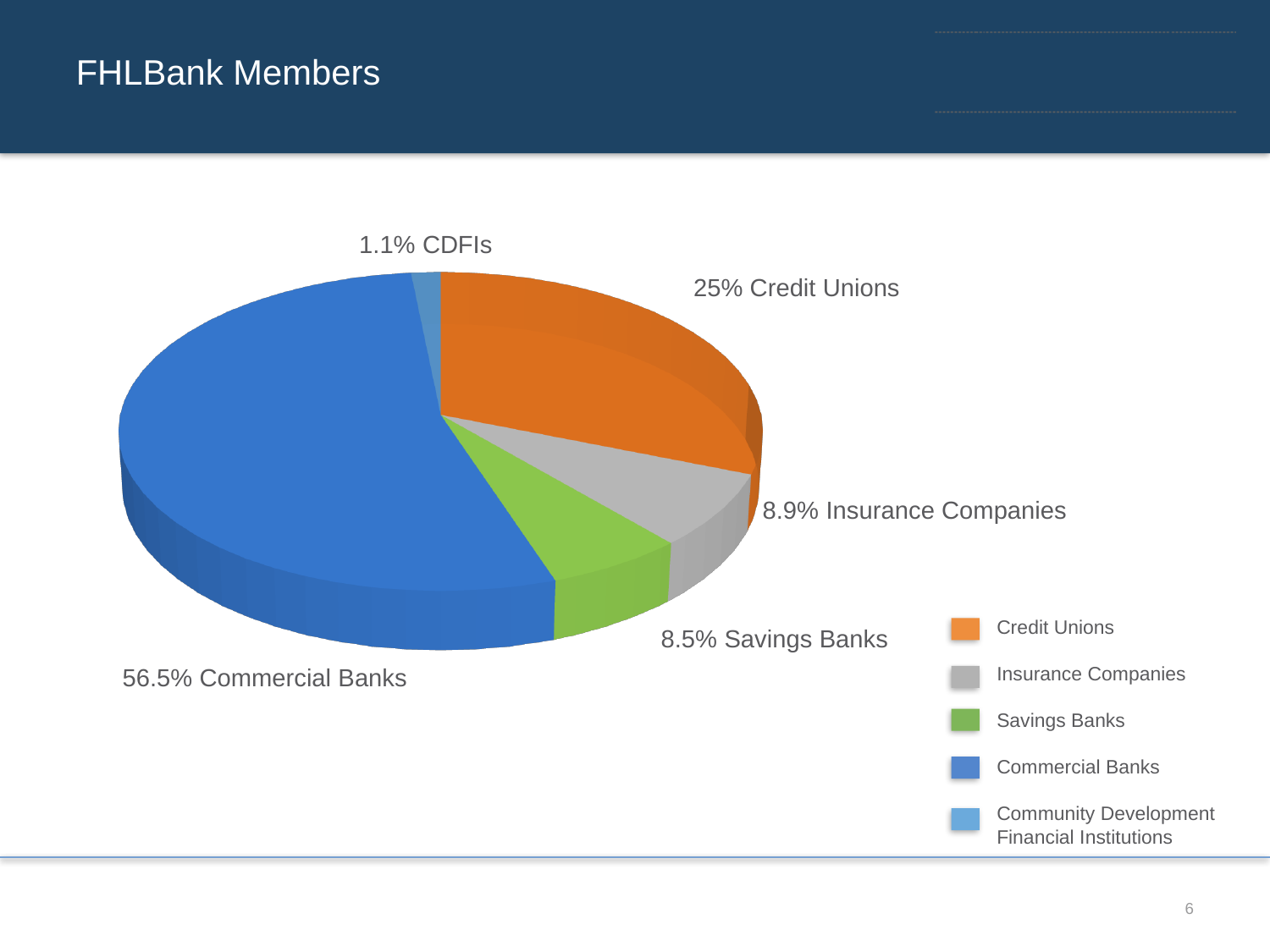
What share of FHLBank members are CDFIs? 1.1% What share of FHLBank members are Savings Banks? 8.5% What is the difference in percentage points between Commercial Banks and Credit Unions? 31.5 Which member category has the largest share of the pie? Commercial Banks Which is larger, the share for Credit Unions or the share for Insurance Companies? Credit Unions What colour represents Savings Banks in the pie chart? Green How many categories does the pie chart show? 5 What share of FHLBank members are Commercial Banks? 56.5% What share of FHLBank members are Credit Unions? 25% Which member category has the smallest share of the pie? CDFIs What share of FHLBank members are Insurance Companies? 8.9% What type of chart is shown on the slide? Pie chart